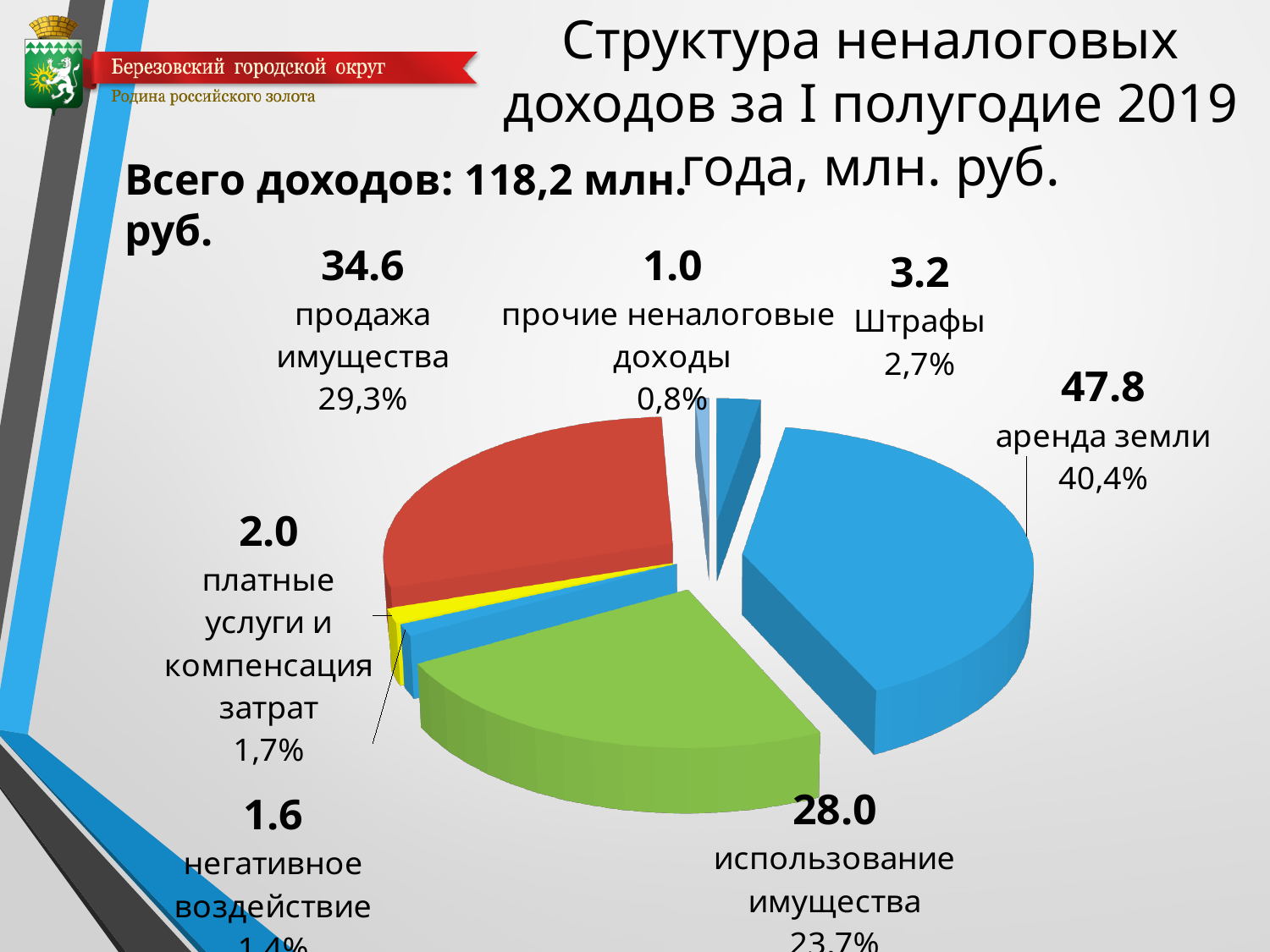
Which category has the largest value? аренда земли What type of chart is shown on the slide? pie chart What is the value for Штрафы? 3.2 What is the value for использование имущества? 28.0 Which category has the smallest value? прочие неналоговые доходы What share of the pie does использование имущества represent? 23,7% What is the difference between the values for аренда земли and продажа имущества? 13.2 What is the value for аренда земли? 47.8 What share of the pie does платные услуги и компенсация затрат represent? 1,7% Which is larger: the value for использование имущества or the value for продажа имущества? продажа имущества What is the value for продажа имущества? 34.6 How many categories does the pie chart show? 7